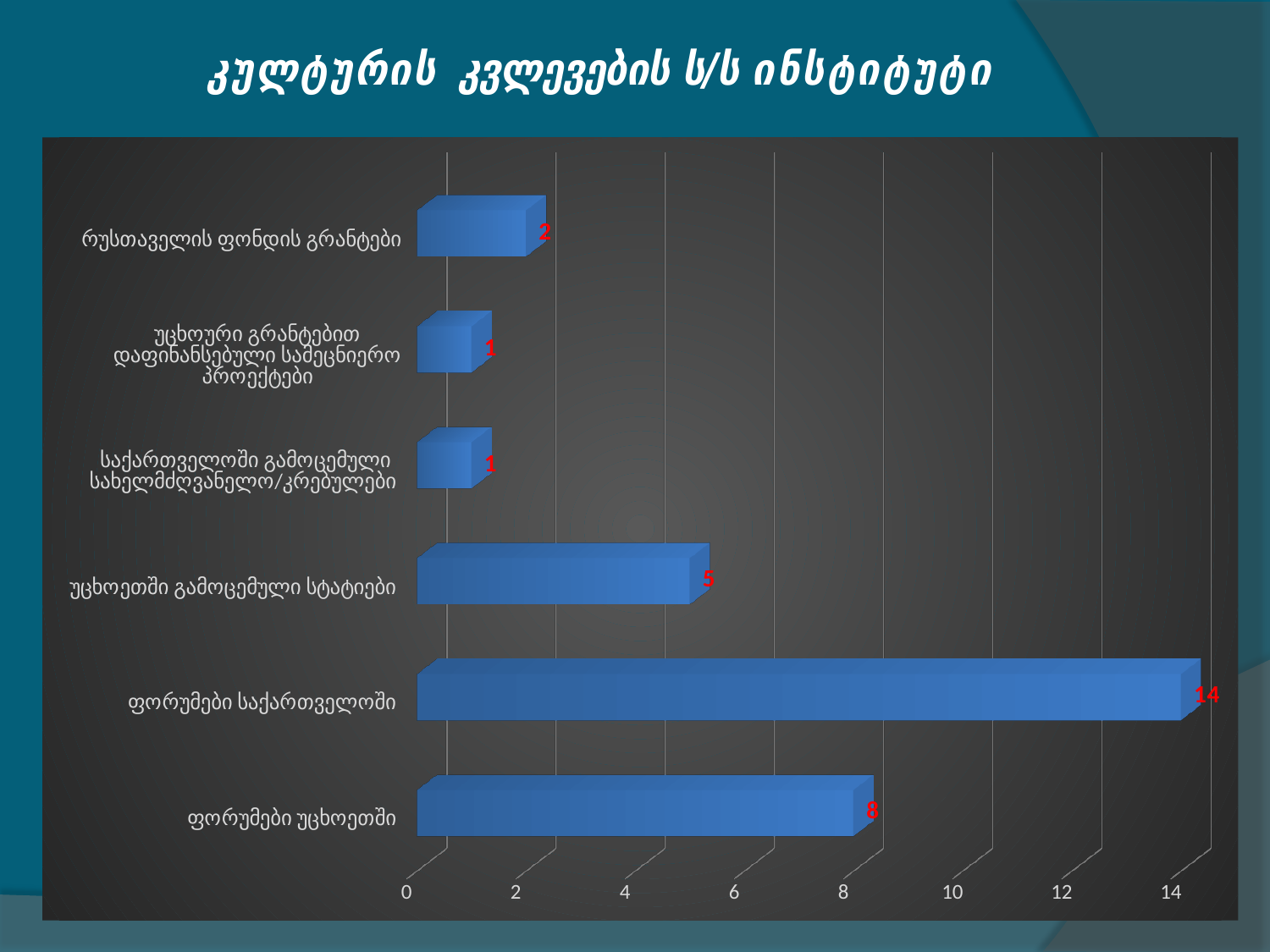
How many categories are shown in the chart? 6 What is the maximum value shown on the horizontal axis? 14 What is the difference between the values for ფორუმები უცხოეთში and უცხოეთში გამოცემული სტატიები? 3 Which category has the highest value? ფორუმები საქართველოში What is the difference between the values for ფორუმები საქართველოში and ფორუმები უცხოეთში? 6 What is the title of the slide? კულტურის კვლევების ს/ს ინსტიტუტი What is the value for ფორუმები საქართველოში? 14 What type of chart is shown on the slide? bar chart What is the value for უცხოეთში გამოცემული სტატიები? 5 What is the value for რუსთაველის ფონდის გრანტები? 2 Which is larger, the value for უცხოეთში გამოცემული სტატიები or the value for რუსთაველის ფონდის გრანტები? უცხოეთში გამოცემული სტატიები What is the value for ფორუმები უცხოეთში? 8